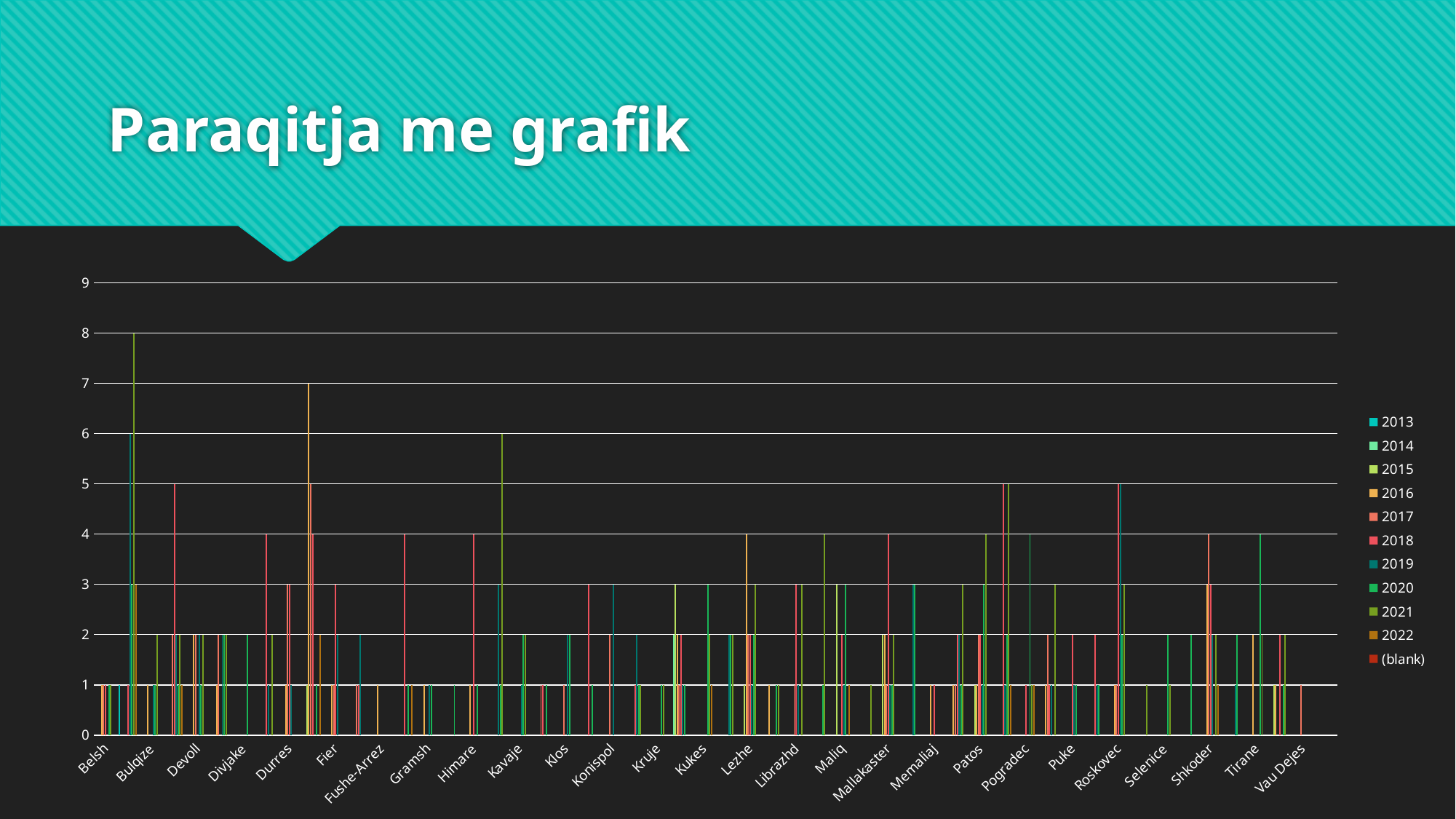
What kind of chart is shown on the slide? bar chart How many series does the chart's legend list? 11 What is the highest value shown on the vertical axis? 9 What is the title of the slide containing the chart? Paraqitja me grafik Is the tallest bar at Belsh greater or less than 2? less What is the last entry in the chart's legend? (blank)